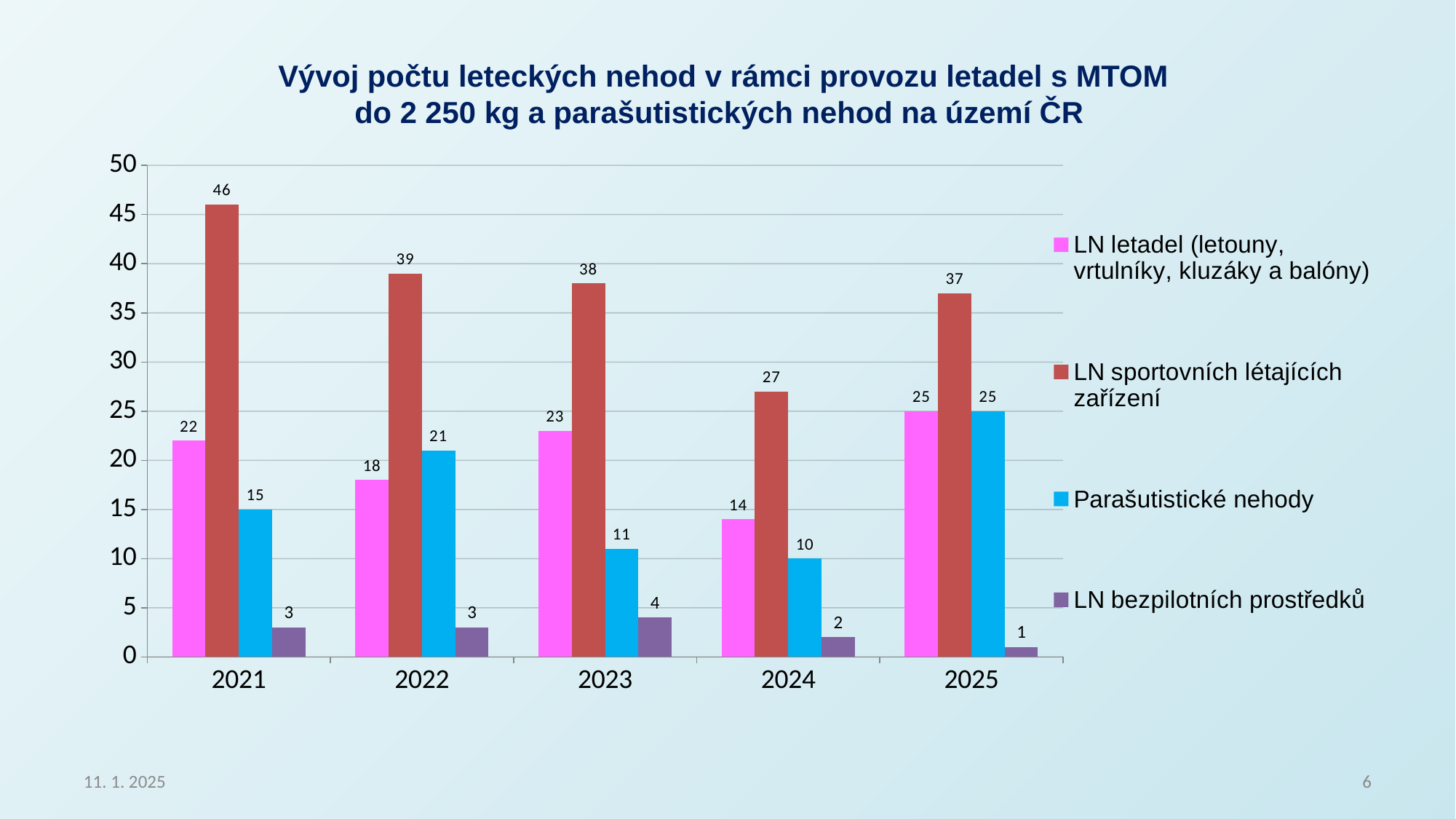
Does the value for LN sportovních létajících zařízení rise or fall from 2021 to 2024? Fall What is the value for LN sportovních létajících zařízení in 2021? 46 What kind of chart is shown on the slide? Bar chart What is the value for LN bezpilotních prostředků in 2025? 1 What is the difference between LN sportovních létajících zařízení and LN letadel (letouny, vrtulníky, kluzáky a balóny) in 2023? 15 In which year is the value for LN letadel (letouny, vrtulníky, kluzáky a balóny) lowest? 2024 Which is larger in 2024: Parašutistické nehody or LN letadel (letouny, vrtulníky, kluzáky a balóny)? LN letadel (letouny, vrtulníky, kluzáky a balóny) How many series does the legend list? 4 How many years are shown on the x axis? 5 In which year is the value for LN sportovních létajících zařízení highest? 2021 What is the value for Parašutistické nehody in 2022? 21 Which colour represents Parašutistické nehody in the legend? Blue